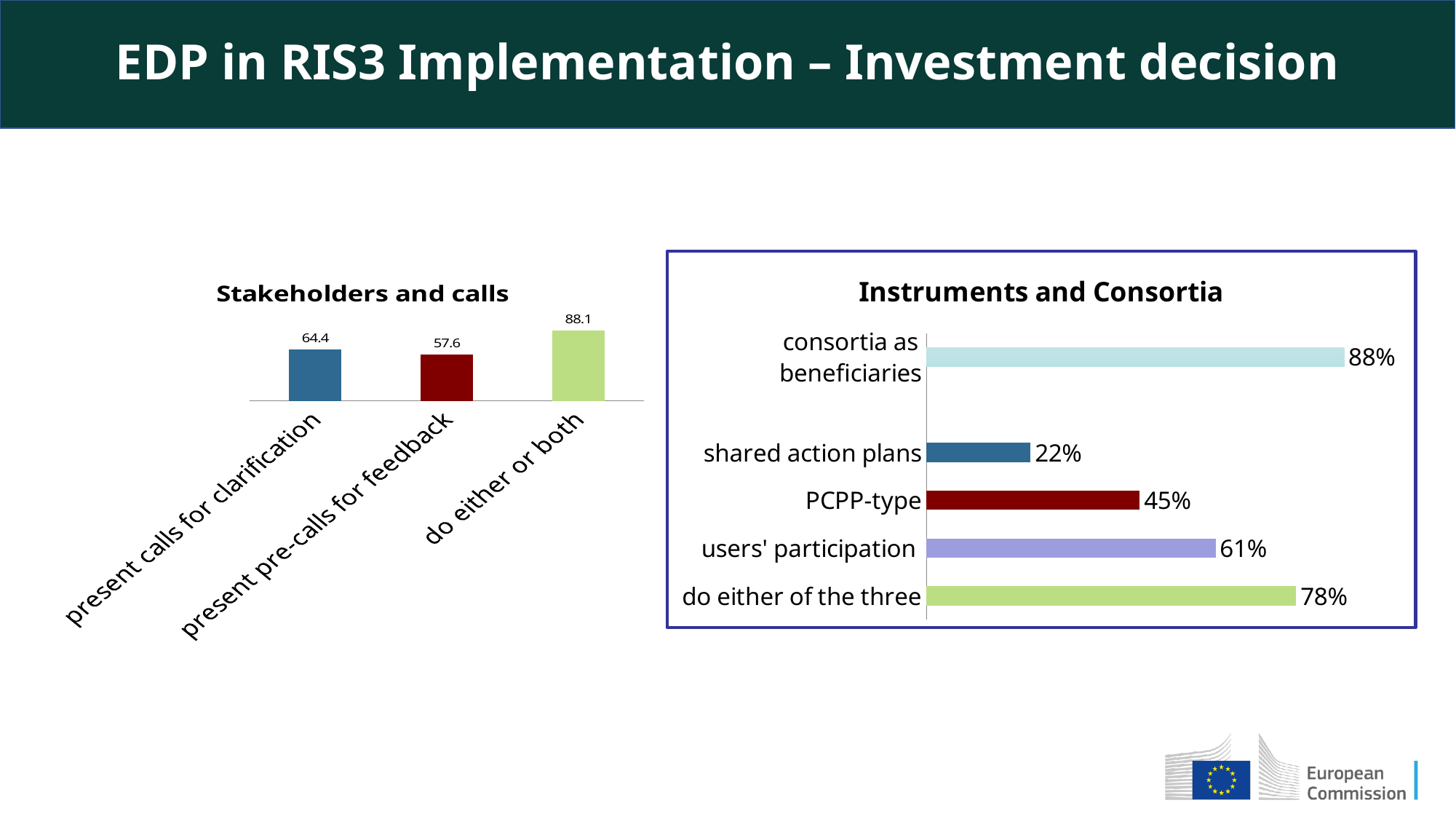
In the 'Stakeholders and calls' chart, which category has the lowest value? present pre-calls for feedback How many categories are shown in the 'Stakeholders and calls' chart? 3 In the 'Stakeholders and calls' chart, what is the value for 'present calls for clarification'? 64.4 In the 'Instruments and Consortia' chart, what is the difference between 'consortia as beneficiaries' and 'shared action plans'? 66% In the 'Stakeholders and calls' chart, what is the value for 'present pre-calls for feedback'? 57.6 In the 'Stakeholders and calls' chart, which category has the highest value? do either or both In the 'Instruments and Consortia' chart, what is the value for 'users' participation'? 61% In the 'Instruments and Consortia' chart, what is the value for 'PCPP-type'? 45% In the 'Instruments and Consortia' chart, which is larger: 'do either of the three' or 'consortia as beneficiaries'? consortia as beneficiaries What kind of chart is the 'Instruments and Consortia' chart? bar chart In the 'Stakeholders and calls' chart, what is the difference between 'do either or both' and 'present calls for clarification'? 23.7 In the 'Instruments and Consortia' chart, which category has the lowest value? shared action plans